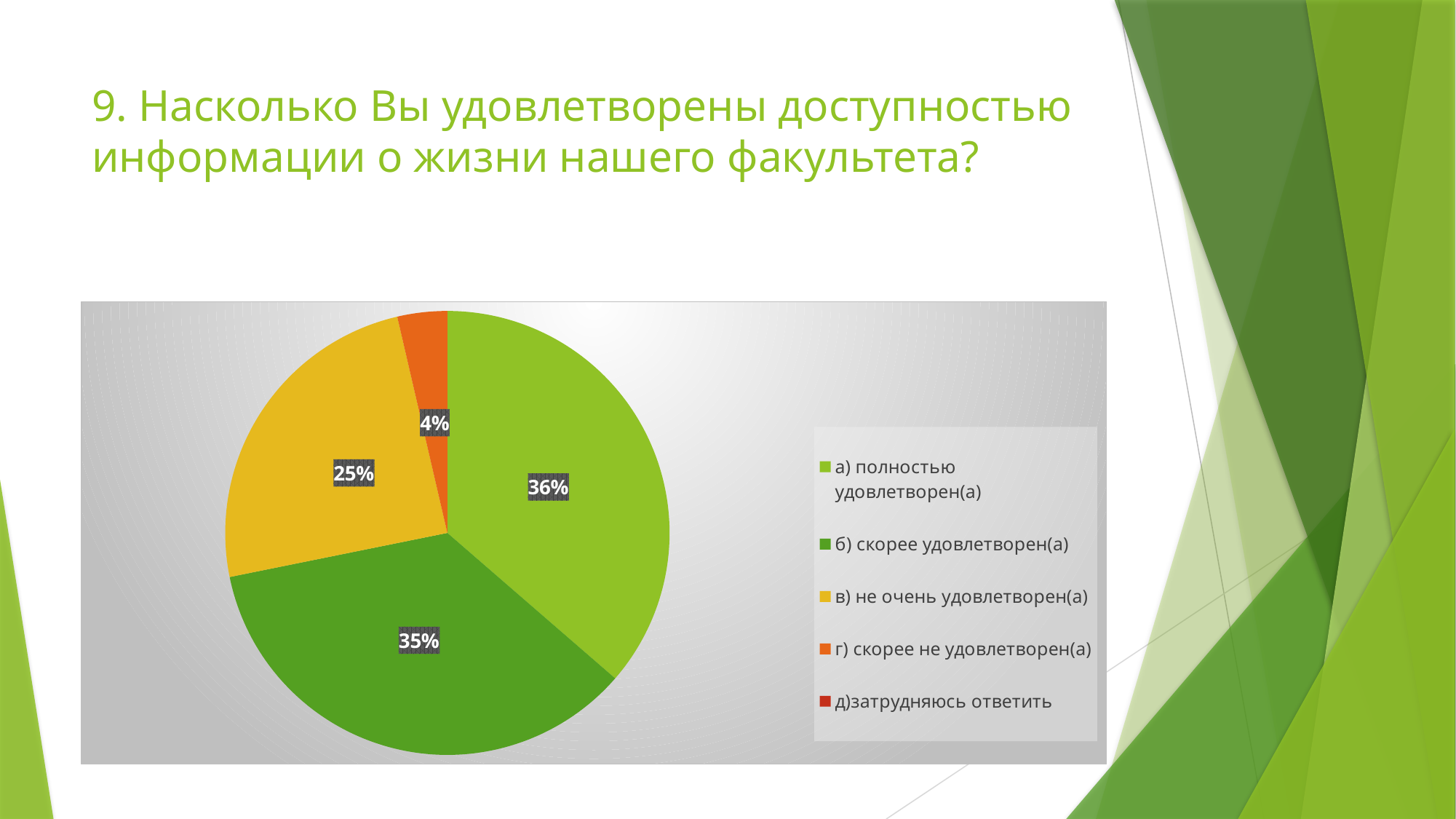
What percentage of respondents answered "в) не очень удовлетворен(а)"? 25% What percentage of respondents answered "а) полностью удовлетворен(а)"? 36% What colour is the slice for "в) не очень удовлетворен(а)"? yellow Which answer option has the smallest labelled slice in the pie chart? г) скорее не удовлетворен(а) What percentage of respondents answered "б) скорее удовлетворен(а)"? 35% Which is larger: the share for "в) не очень удовлетворен(а)" or the share for "г) скорее не удовлетворен(а)"? в) не очень удовлетворен(а) How many entries does the legend of the pie chart list? 5 Which answer option has the largest slice in the pie chart? а) полностью удовлетворен(а) What is the difference in percentage points between "а) полностью удовлетворен(а)" and "в) не очень удовлетворен(а)"? 11 What type of chart is shown on the slide? pie chart How many slices in the pie chart have a percentage label shown? 4 What percentage of respondents answered "г) скорее не удовлетворен(а)"? 4%